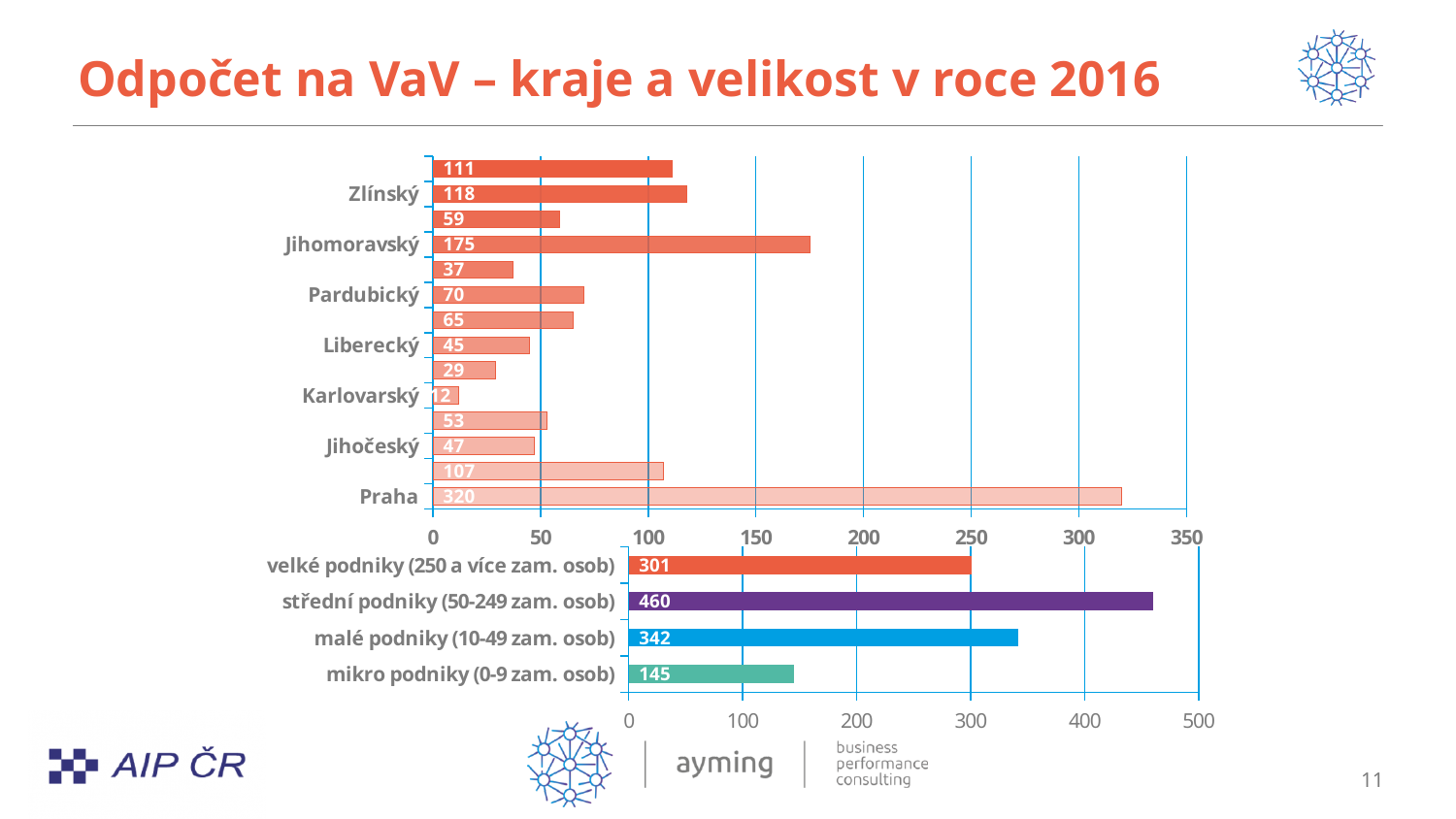
In the top chart (regions), how many bars are plotted? 14 In the bottom chart (company sizes), is the value for mikro podniky greater or less than 200? less In the bottom chart (company sizes), what is the difference between the values for malé podniky and velké podniky? 41 What kind of chart is the bottom chart (company sizes)? bar chart In the top chart (regions), what is the difference between the values for Praha and Jihomoravský? 145 In the top chart (regions), what is the value for Praha? 320 In the top chart (regions), which is larger, the value for Zlínský or the value for Pardubický? Zlínský In the bottom chart (company sizes), which category has the lowest value? mikro podniky (0-9 zam. osob) In the top chart (regions), what is the value for Jihomoravský? 175 In the bottom chart (company sizes), which category has the highest value? střední podniky (50-249 zam. osob) In the bottom chart (company sizes), how many categories are shown? 4 In the bottom chart (company sizes), what is the value for střední podniky (50-249 zam. osob)? 460